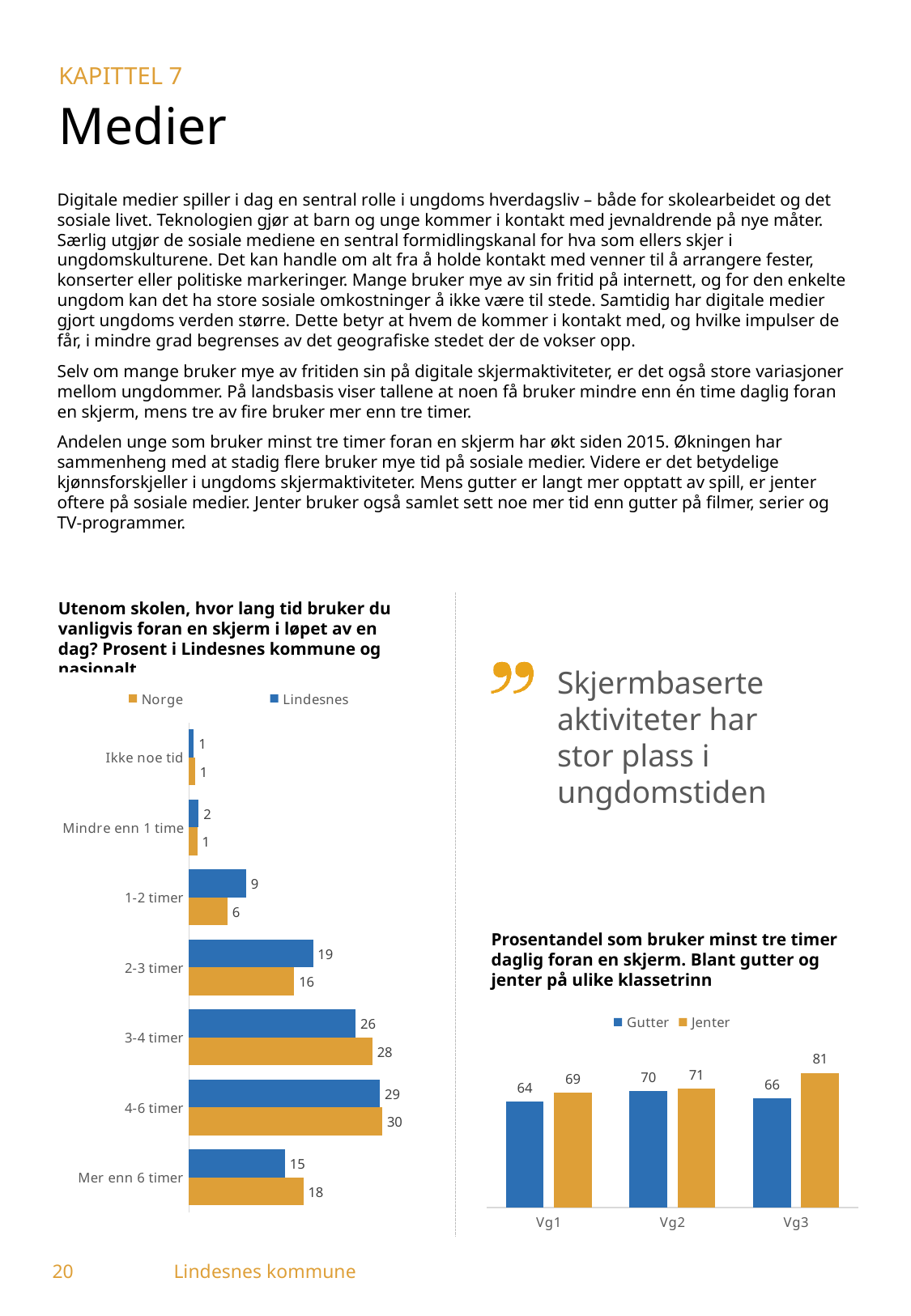
In the left chart (screen time per day), how many series does the legend list? 2 In the left chart (screen time per day), what is the Norge value for 'Mer enn 6 timer'? 18 In the right chart (minst tre timer daglig), what is the Jenter value for Vg3? 81 In the left chart (screen time per day), which category has the highest Norge value? 4-6 timer In the left chart (screen time per day), which is larger for '3-4 timer': Norge or Lindesnes? Norge In the left chart (screen time per day), how many categories are shown? 7 In the right chart (minst tre timer daglig), what is the Gutter value for Vg2? 70 In the left chart (screen time per day), what is the Lindesnes value for '4-6 timer'? 29 In the right chart (minst tre timer daglig), what is the difference between Jenter and Gutter for Vg3? 15 In the left chart (screen time per day), what is the difference between the Lindesnes and Norge values for '1-2 timer'? 3 What kind of chart is the right chart (minst tre timer daglig)? Bar chart In the right chart (minst tre timer daglig), which class level has the lowest Gutter value? Vg1